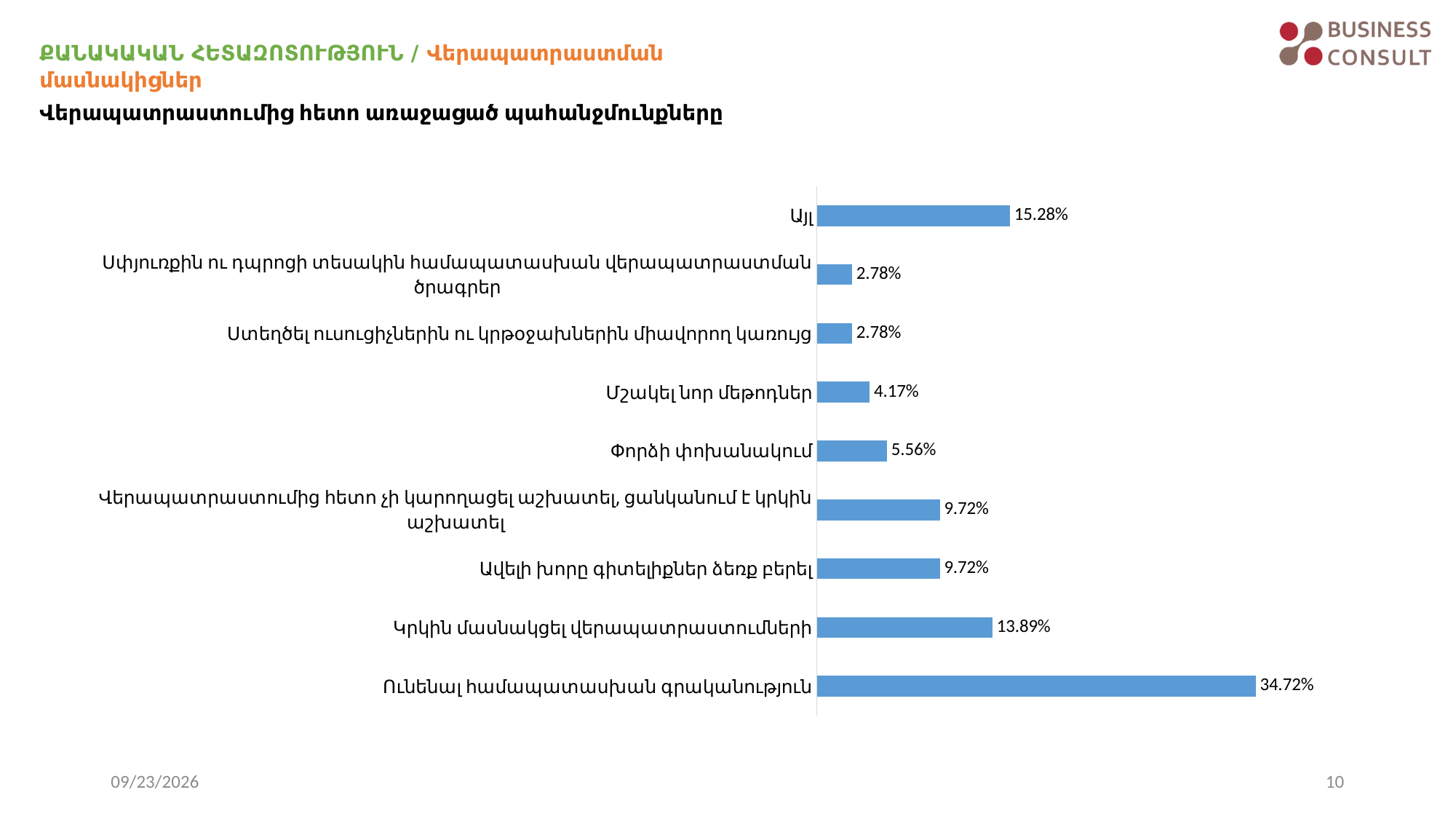
What is the value for "Փորձի փոխանակում"? 5.56% What is the value for "Մշակել նոր մեթոդներ"? 4.17% Which is larger: the value for "Այլ" or the value for "Կրկին մասնակցել վերապատրաստումների"? Այլ What is the title of the chart? Վերապատրաստումից հետո առաջացած պահանջմունքները How many categories are plotted in the chart? 9 What is the value for "Այլ"? 15.28% What is the difference between the values for "Ավելի խորը գիտելիքներ ձեռք բերել" and "Փորձի փոխանակում"? 4.16% What is the value for "Ունենալ համապատասխան գրականություն"? 34.72% Which category has the highest value? Ունենալ համապատասխան գրականություն What is the value for "Կրկին մասնակցել վերապատրաստումների"? 13.89% What kind of chart is shown on the slide? bar chart What is the difference between the values for "Ունենալ համապատասխան գրականություն" and "Կրկին մասնակցել վերապատրաստումների"? 20.83%